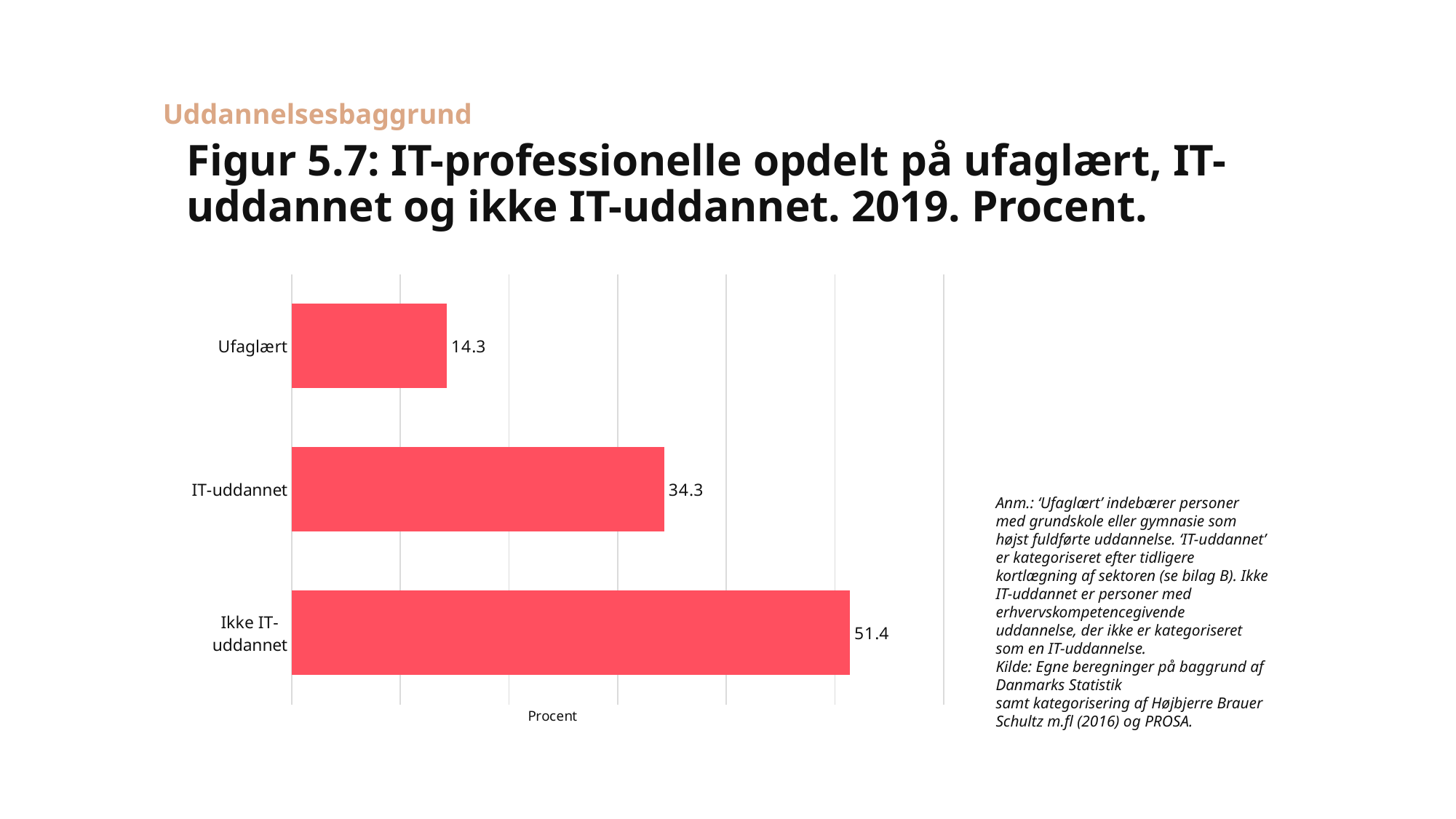
Which is larger, the value for IT-uddannet or the value for Ufaglært? IT-uddannet What colour are the bars in the chart? Red What is the difference between the values for IT-uddannet and Ufaglært? 20 What is the value for Ikke IT-uddannet? 51.4 How many categories are shown in the chart? 3 What is the value for IT-uddannet? 34.3 What is the difference between the values for Ikke IT-uddannet and IT-uddannet? 17.1 Which category has the highest value? Ikke IT-uddannet Which category has the lowest value? Ufaglært What is the value for Ufaglært? 14.3 What kind of chart is shown on the slide? Bar chart What is the label on the horizontal axis of the chart? Procent